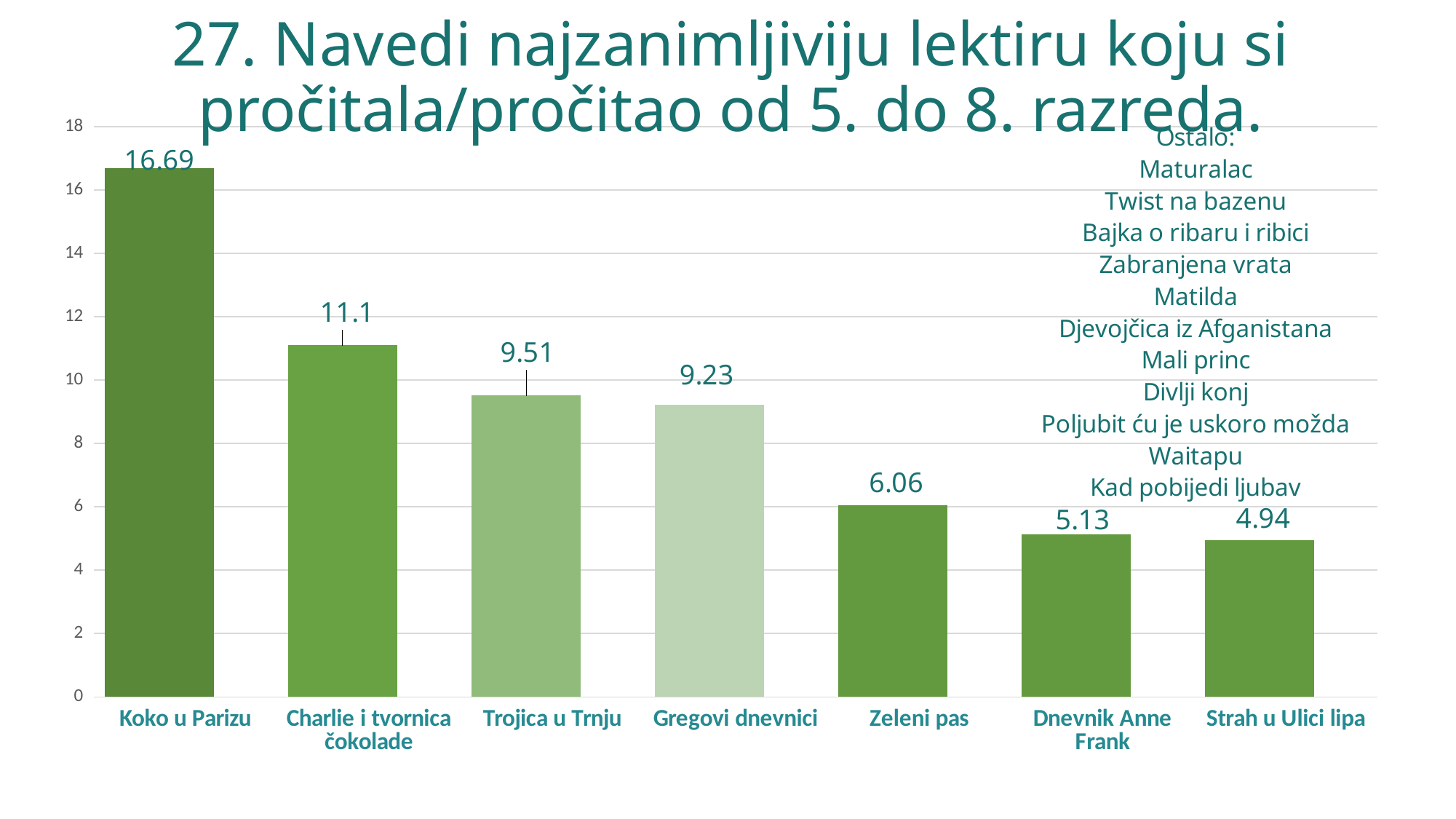
What kind of chart is shown on the slide? bar chart Which category has the highest value? Koko u Parizu Which category has the lowest value? Strah u Ulici lipa How many categories are shown in the chart? 7 What is the value for Koko u Parizu? 16.69 What is the value for Gregovi dnevnici? 9.23 What is the difference between the values for Zeleni pas and Strah u Ulici lipa? 1.12 What is the value for Charlie i tvornica čokolade? 11.1 Which is larger, the value for Trojica u Trnju or the value for Zeleni pas? Trojica u Trnju Do the values rise or fall from left to right along the x axis? fall What is the value for Dnevnik Anne Frank? 5.13 What is the difference between the values for Koko u Parizu and Charlie i tvornica čokolade? 5.59